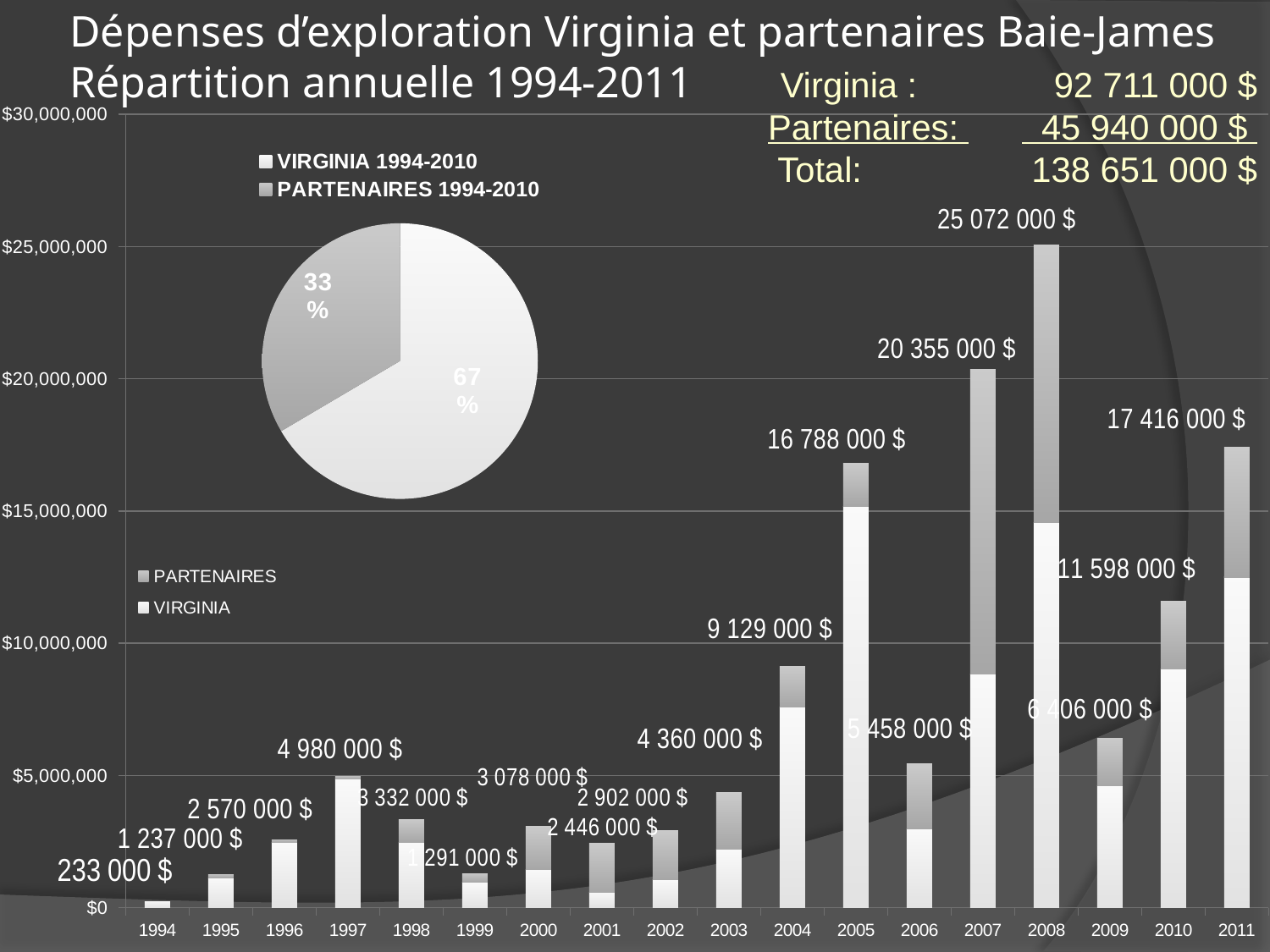
In the bar chart, which year has the lowest total? 1994 In the bar chart, which year has the highest total? 2008 How many years are shown on the x axis of the bar chart? 18 In the bar chart, what is the total labelled for 2008? 25 072 000 $ In the bar chart, what is the total labelled for 1994? 233 000 $ What kind of chart shows the annual breakdown by year? Stacked bar chart In the bar chart, what is the difference between the totals for 2008 and 2007? 4 717 000 $ In the bar chart, is the total for 2010 greater or less than $10,000,000? greater In the bar chart, what is the total labelled for 2005? 16 788 000 $ How many series does the bar chart's legend list? 2 In the bar chart, which year has a larger total, 2011 or 2005? 2011 In the pie chart, what share is labelled for PARTENAIRES 1994-2010? 33%